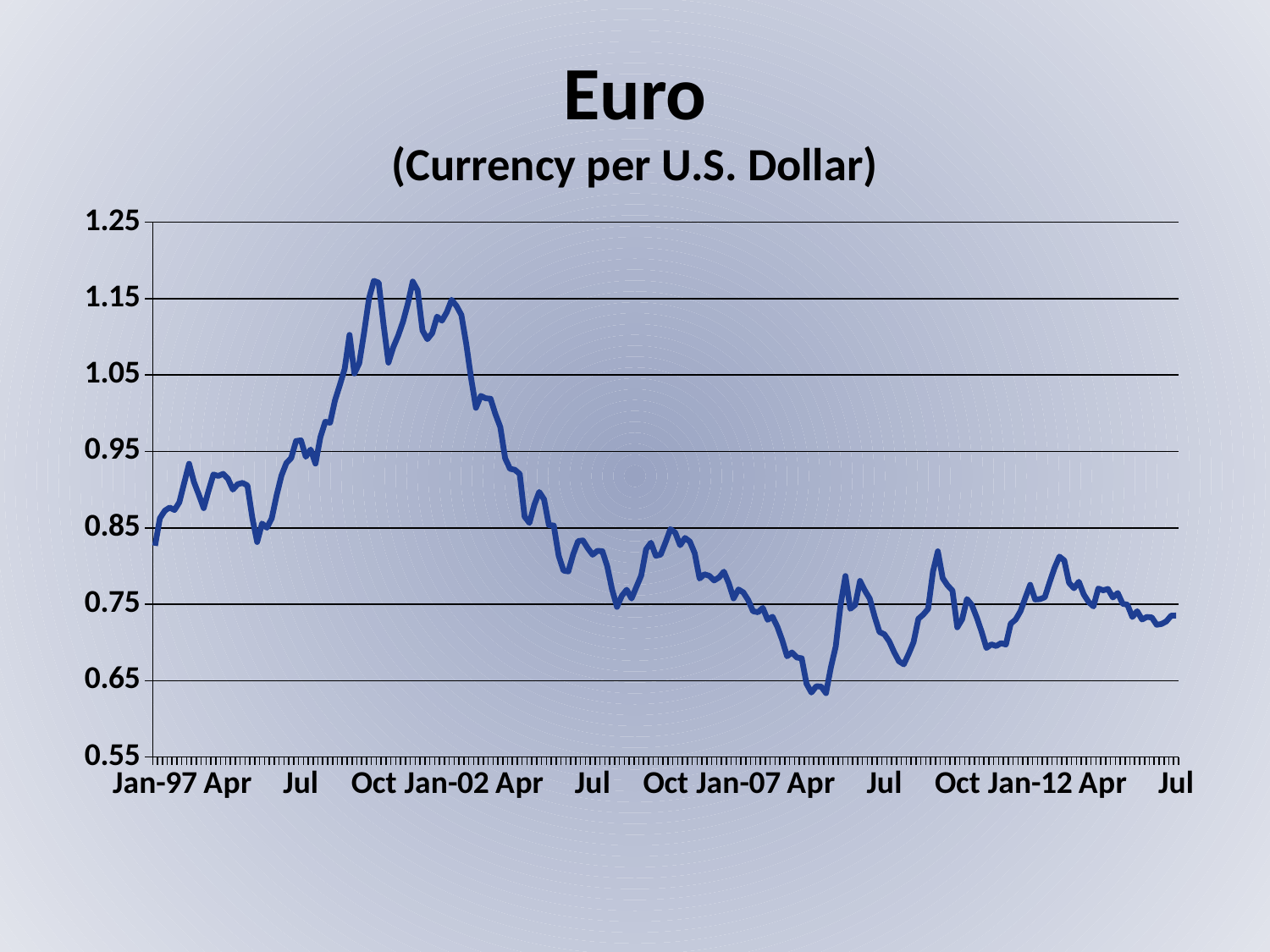
What kind of chart is shown on the slide? line chart Is the value at Jan-97 greater or less than 0.75? greater Which is larger, the value at Jan-02 or the value at Jan-12? Jan-02 Does the line generally rise or fall between Jan-02 and Jan-07? fall Is the value at Jan-07 greater or less than 0.85? less Is the value at Jan-12 greater or less than 0.85? less What is the highest value shown on the vertical axis? 1.25 What is the title of the chart? Euro (Currency per U.S. Dollar) Does the line generally rise or fall between Jan-97 and Jan-02? rise